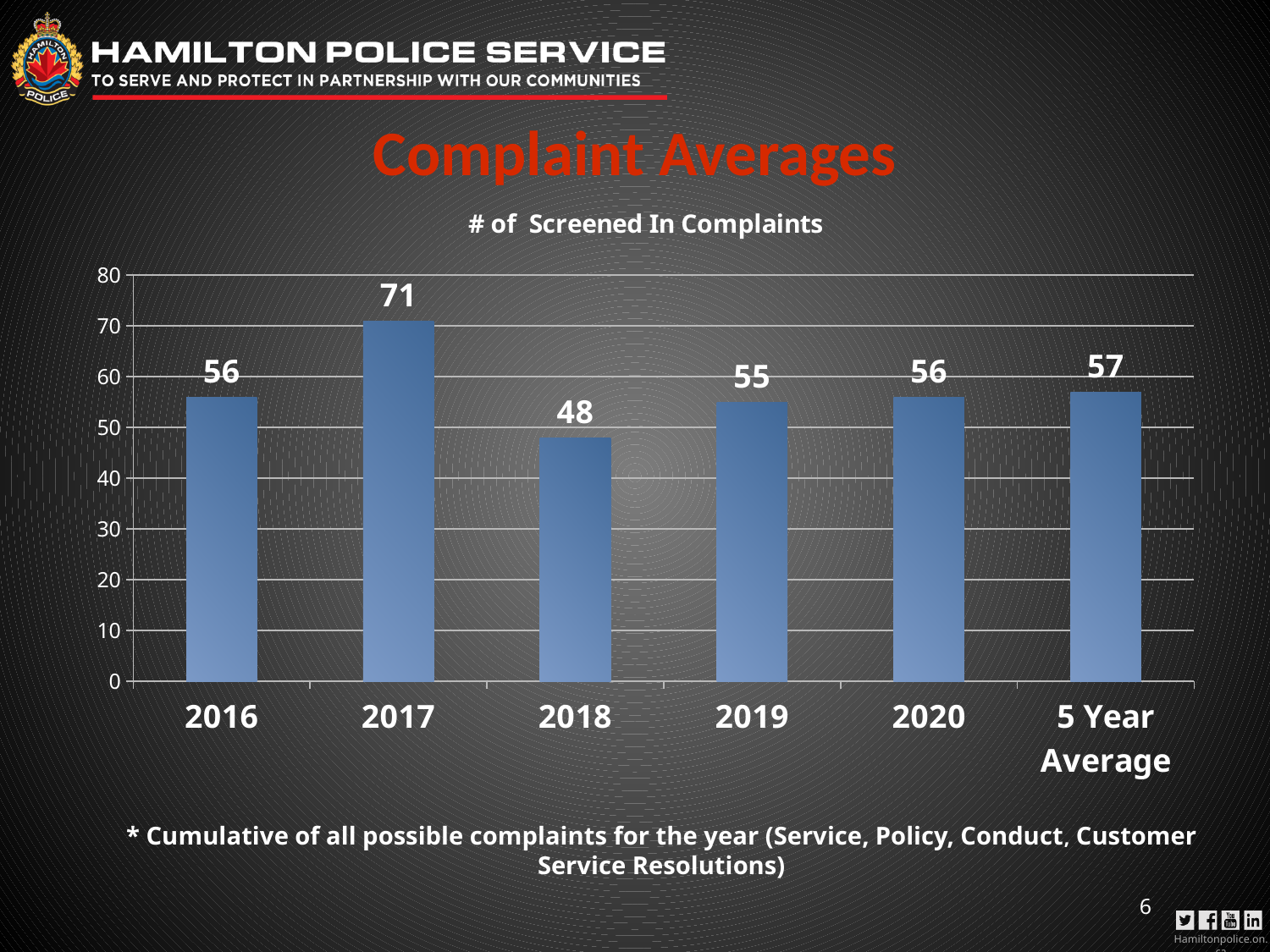
Which year has the highest number of screened in complaints? 2017 What is the value shown for the 5 Year Average? 57 Did the number of screened in complaints rise or fall from 2017 to 2018? Fall What is the number of screened in complaints for 2017? 71 What is the number of screened in complaints for 2018? 48 Which year has the lowest number of screened in complaints? 2018 How many bars are shown in the chart? 6 Which is larger, the value for 2019 or the value for 2020? 2020 What kind of chart is shown on the slide? Bar chart What is the difference between the 2017 and 2018 values? 23 Is the value for 2017 greater or less than 60? greater What is the title of the chart? # of Screened In Complaints